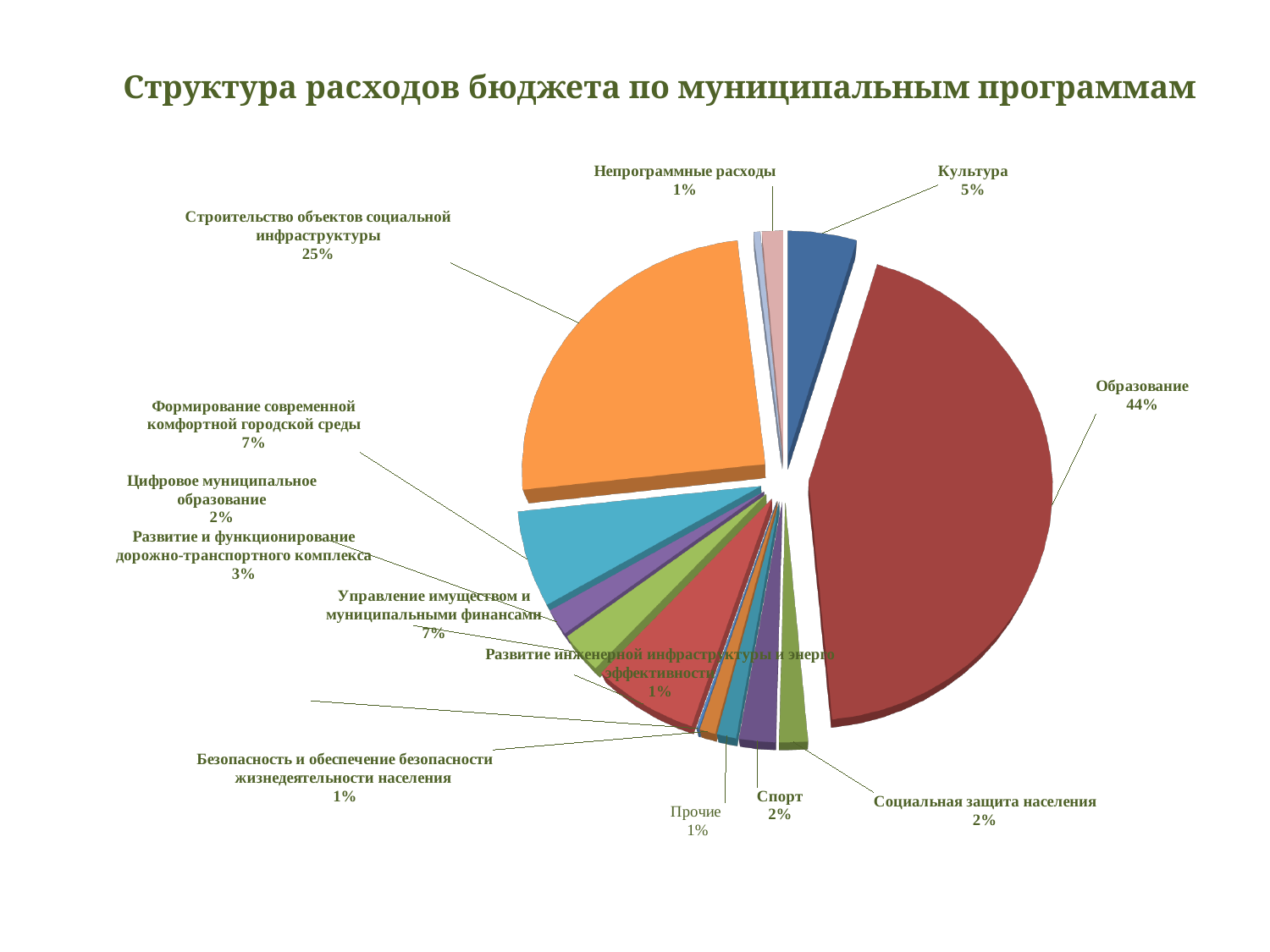
What is the value shown for Культура? 5% How many categories are shown in the pie chart? 14 What share of the pie does Строительство объектов социальной инфраструктуры take? 25% What kind of chart is shown on the slide? pie chart What is the value shown for Формирование современной комфортной городской среды? 7% Which category has the largest share of the pie? Образование Which is larger, the share for Культура or the share for Спорт? Культура What is the difference between the shares of Образование and Строительство объектов социальной инфраструктуры? 19% What is the value shown for Непрограммные расходы? 1% What is the title of the chart? Структура расходов бюджета по муниципальным программам What is the value shown for Развитие и функционирование дорожно-транспортного комплекса? 3% What share of the pie does Образование take? 44%